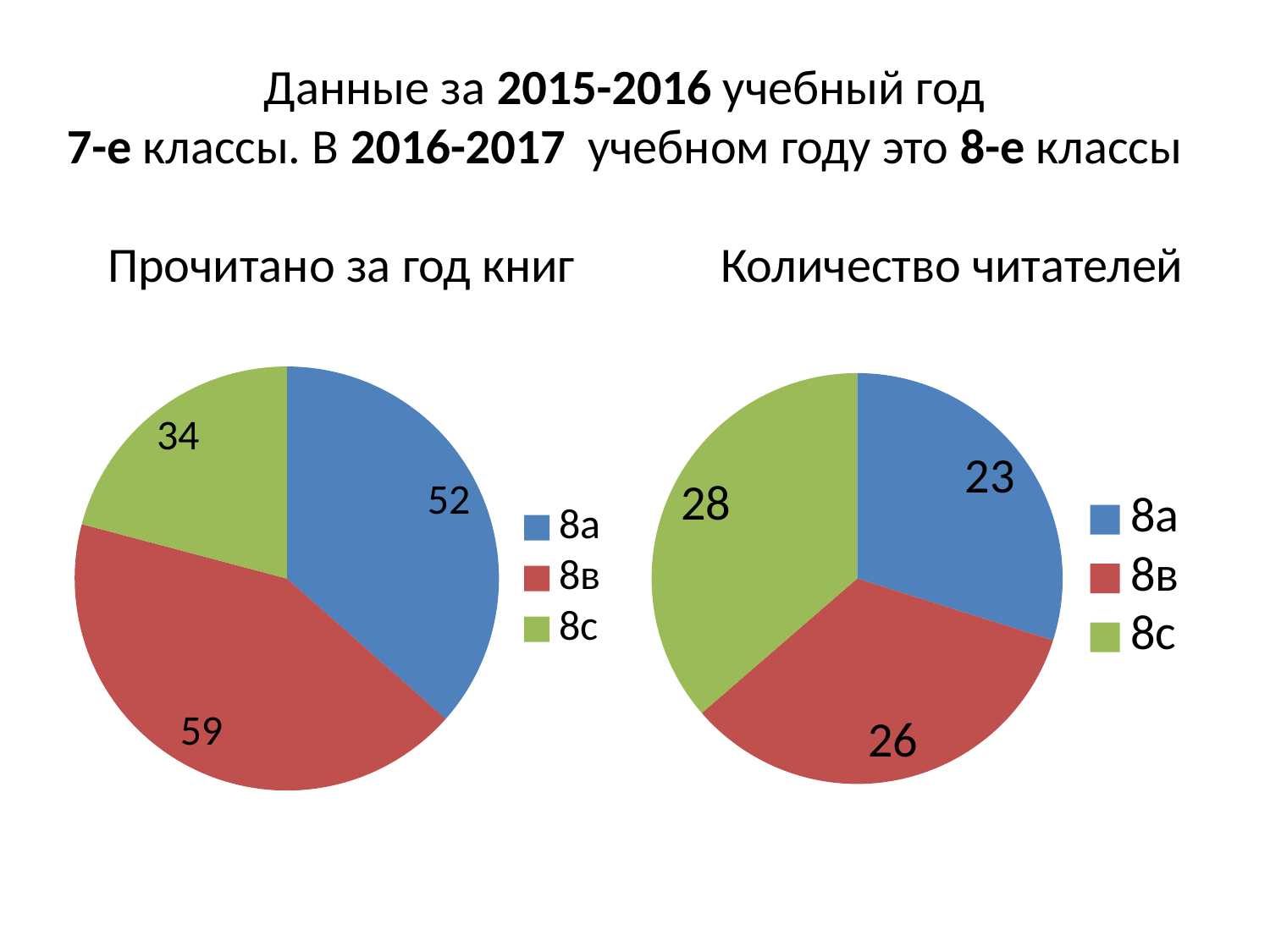
In the chart titled "Прочитано за год книг", which class has the smallest slice? 8с In the chart titled "Прочитано за год книг", what is the value for 8с? 34 In the chart titled "Прочитано за год книг", what is the value for 8в? 59 In the chart titled "Количество читателей", what is the difference between the values for 8с and 8а? 5 What type of chart is the chart titled "Количество читателей"? Pie chart In the chart titled "Прочитано за год книг", which class has the largest slice? 8в In the chart titled "Количество читателей", which class has the smallest value? 8а In the chart titled "Количество читателей", what is the value for 8а? 23 How many slices does the chart titled "Прочитано за год книг" have? 3 In the chart titled "Количество читателей", which is larger, the value for 8в or the value for 8а? 8в In the chart titled "Прочитано за год книг", what is the difference between the values for 8в and 8с? 25 In the chart titled "Количество читателей", what is the value for 8с? 28